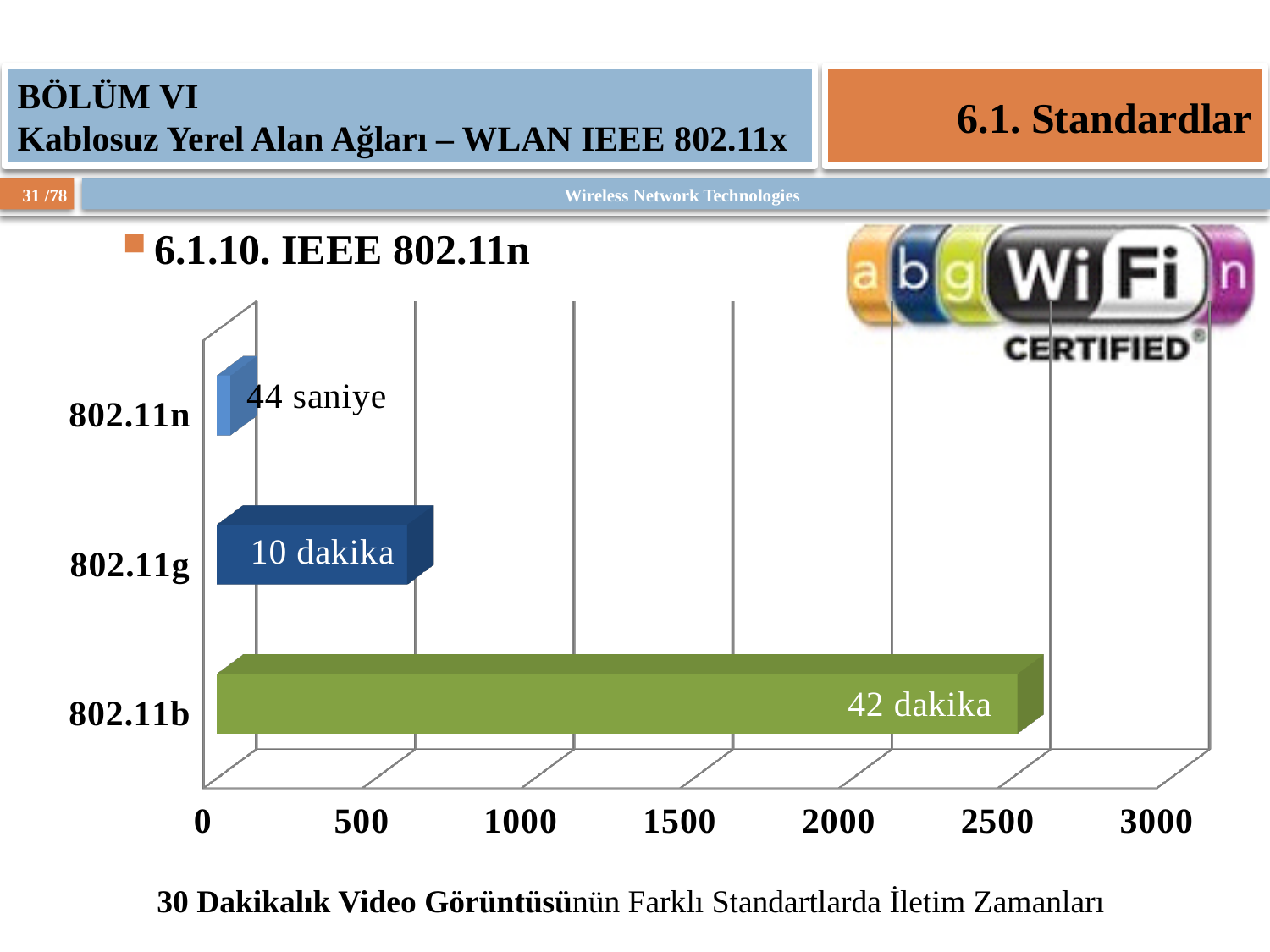
Is the value for 802.11b greater or less than 2000 on the axis? greater What is the data label shown for 802.11n? 44 saniye What kind of chart is shown on the slide? Bar chart Which standard has the longest transmission time (longest bar)? 802.11b What is the data label shown for 802.11g? 10 dakika Is the value for 802.11g greater or less than 1000 on the axis? less How many minutes longer is the 802.11b transmission time than the 802.11g transmission time? 32 dakika How many standards (categories) are plotted in the chart? 3 What is the data label shown for 802.11b? 42 dakika Which standard has the shortest transmission time (shortest bar)? 802.11n What is the maximum value shown on the horizontal axis? 3000 Which has the longer bar, 802.11g or 802.11b? 802.11b